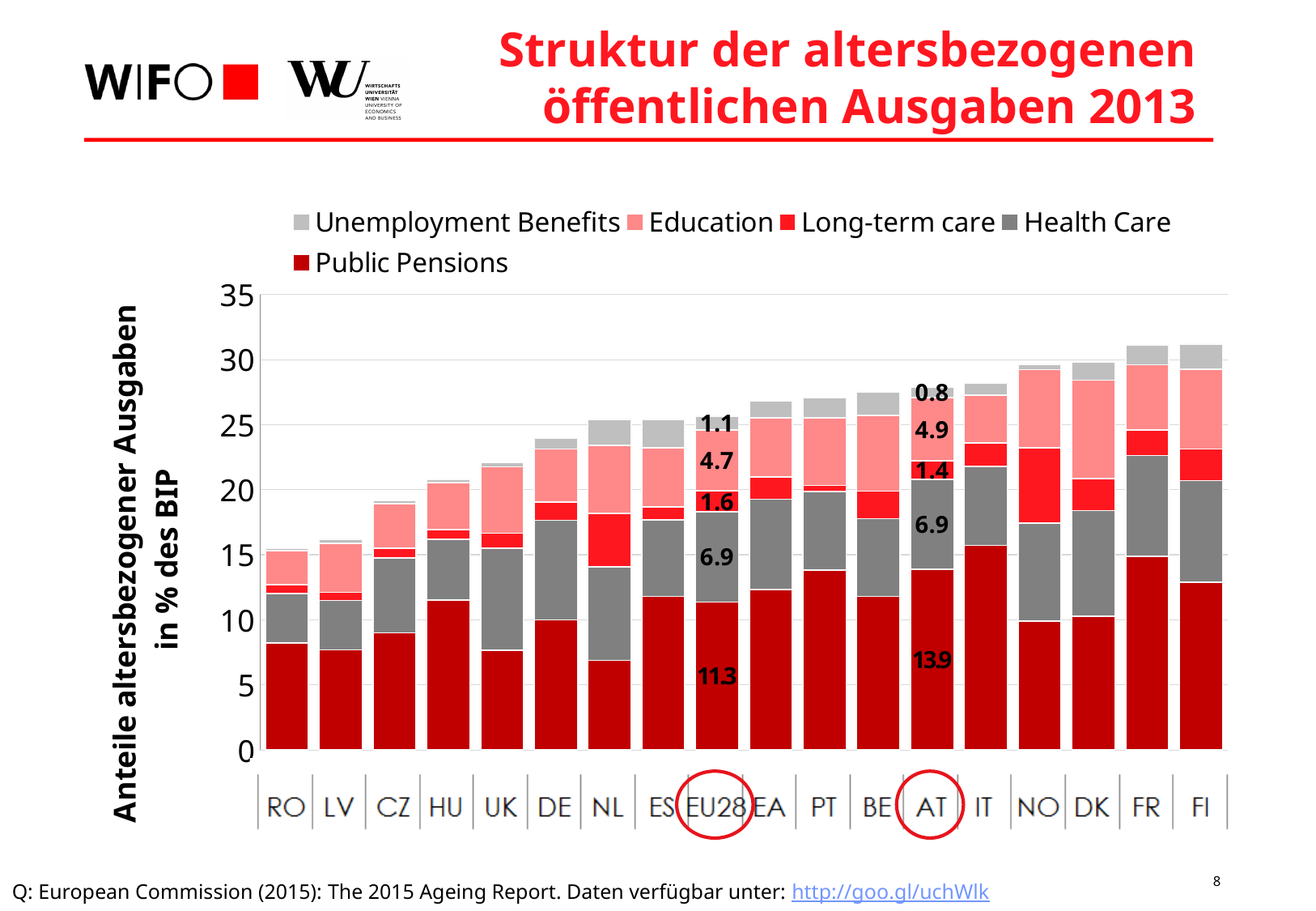
What is the total of the stacked bar for EU28? 25.6 Which has the larger Long-term care value, EU28 or AT? EU28 What is the total of the stacked bar for AT? 27.9 What is the Public Pensions value for EU28? 11.3 Do the total bar heights generally rise or fall from left to right along the x axis? rise What is the Education value for AT? 4.9 How much larger is the Public Pensions value for AT than for EU28? 2.6 How many countries or regions are shown on the x axis? 18 What is the Unemployment Benefits value for EU28? 1.1 How many series does the legend list? 5 What is the Public Pensions value for AT? 13.9 Is the total for FR greater or less than 30? greater